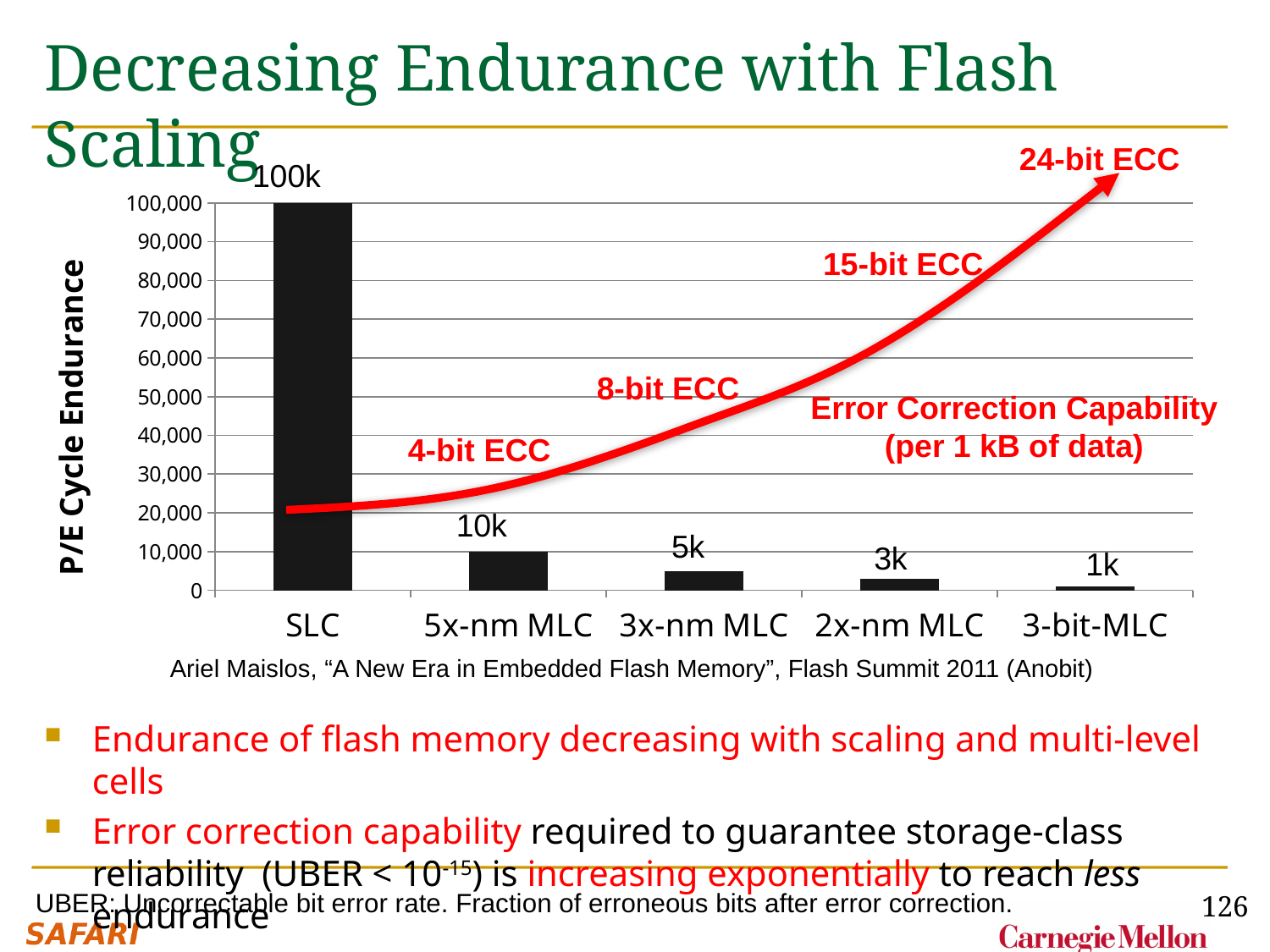
What is the difference in P/E cycle endurance between SLC and 5x-nm MLC? 90k What is the label of the y axis of the chart? P/E Cycle Endurance Which category has the highest P/E cycle endurance? SLC What is the P/E cycle endurance shown for 3-bit-MLC? 1k What is the P/E cycle endurance shown for 3x-nm MLC? 5k Which category has the lowest P/E cycle endurance? 3-bit-MLC What is the difference in P/E cycle endurance between 2x-nm MLC and 3-bit-MLC? 2k Which has a higher P/E cycle endurance, 5x-nm MLC or 2x-nm MLC? 5x-nm MLC Do the P/E cycle endurance values rise or fall from left to right along the x axis? Fall How many categories are shown on the x axis of the bar chart? 5 What kind of chart is used to show P/E cycle endurance? Bar chart What is the P/E cycle endurance shown for SLC? 100k